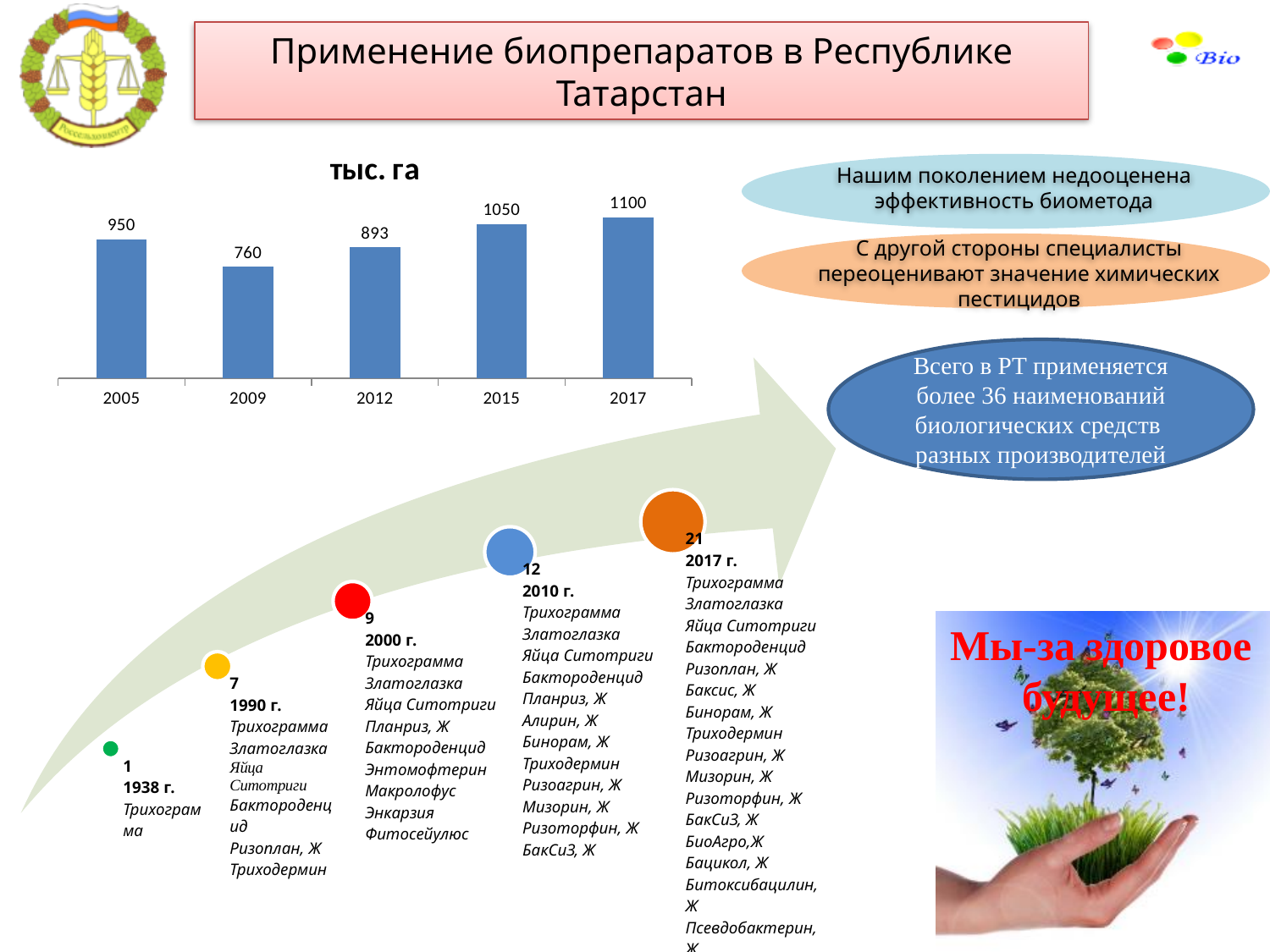
In the "тыс. га" chart, which is larger: the value for 2005 or the value for 2012? 2005 What is the difference between the values for 2017 and 2015 in the "тыс. га" chart? 50 What is the value for 2017 in the "тыс. га" chart? 1100 Which year has the highest value in the "тыс. га" chart? 2017 What is the value for 2005 in the "тыс. га" chart? 950 What kind of chart is the "тыс. га" chart? bar chart What is the value for 2009 in the "тыс. га" chart? 760 What is the difference between the values for 2005 and 2009 in the "тыс. га" chart? 190 Which year has the lowest value in the "тыс. га" chart? 2009 What is the title of the bar chart on the slide? тыс. га What is the value for 2012 in the "тыс. га" chart? 893 How many years are shown on the x axis of the "тыс. га" chart? 5